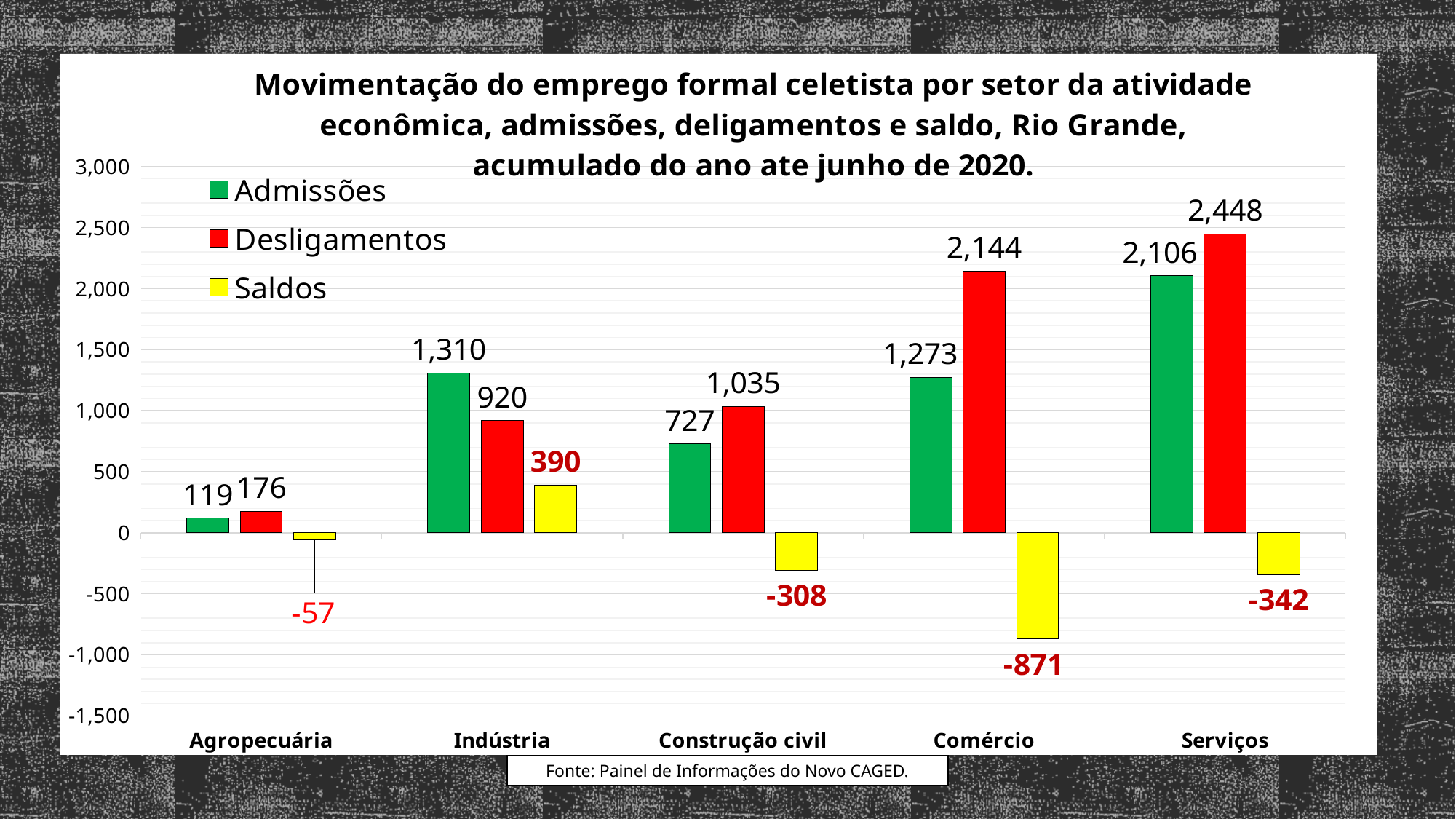
How many series does the legend list? 3 What kind of chart is shown on the slide? Bar chart What is the Saldos value for Construção civil? -308 Which is larger for Indústria, Admissões or Desligamentos? Admissões What is the difference between Desligamentos and Admissões for Serviços? 342 What is the Desligamentos value for Comércio? 2,144 What is the Admissões value for Indústria? 1,310 Which sector has the highest Desligamentos value? Serviços How many sectors are shown on the x axis? 5 Which sector has the lowest Admissões value? Agropecuária Which colour represents the Saldos series in the legend? Yellow Which sector has the lowest Saldos value? Comércio